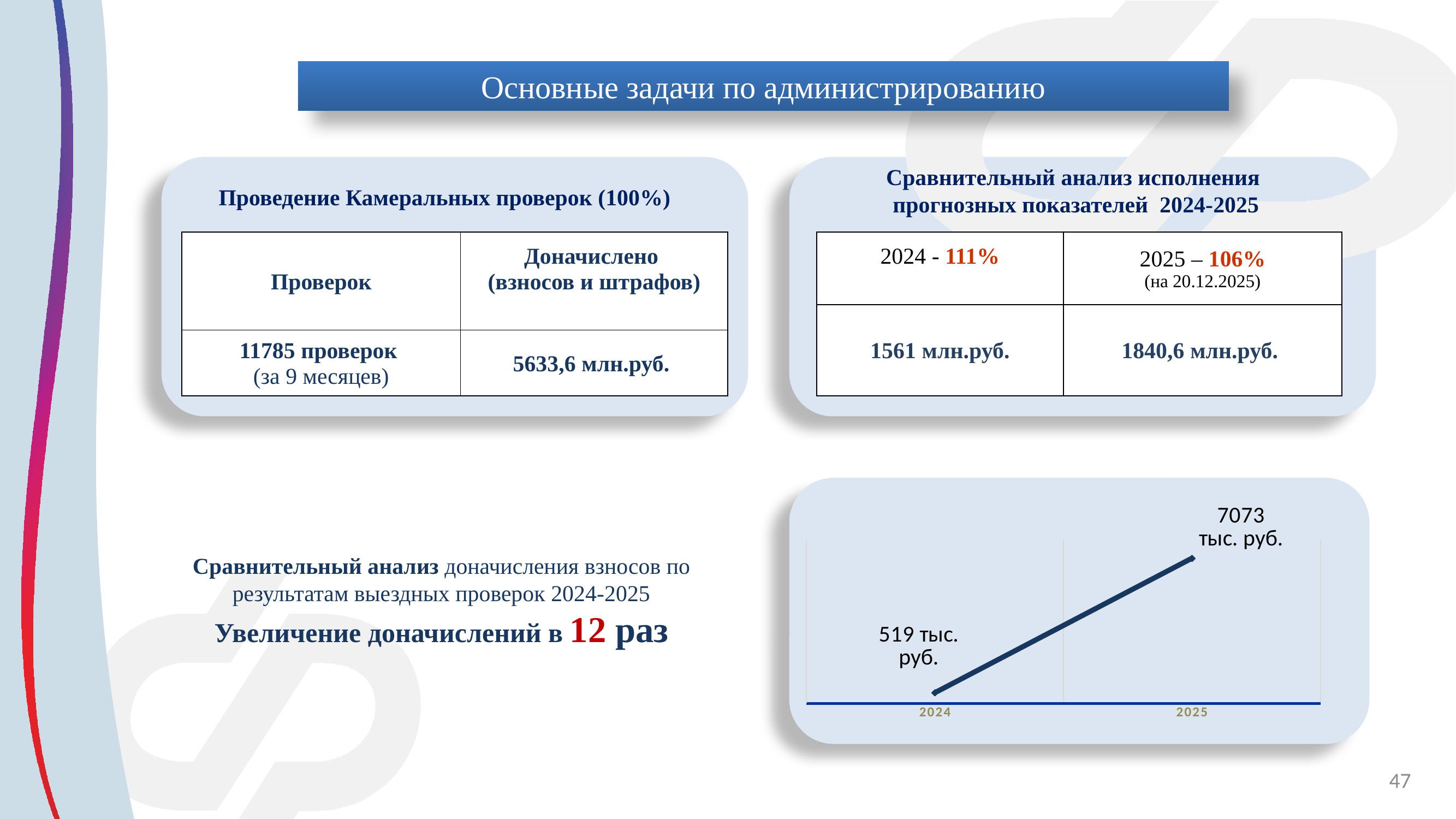
In the line chart at the bottom right, what is the value for 2025? 7073 тыс. руб. In the line chart at the bottom right, what is the difference between the 2025 and 2024 values? 6554 тыс. руб. In the line chart at the bottom right, which year has the highest value? 2025 In the line chart at the bottom right, what is the value for 2024? 519 тыс. руб. How many data points are plotted in the line chart at the bottom right? 2 What kind of chart is shown at the bottom right of the slide? line chart In the line chart at the bottom right, is the value for 2025 larger or smaller than the value for 2024? larger What are the two x-axis labels in the line chart at the bottom right? 2024 and 2025 In what units are the data labels of the line chart at the bottom right expressed? тыс. руб. In the line chart at the bottom right, does the value rise or fall from 2024 to 2025? rise In the line chart at the bottom right, which year has the lowest value? 2024